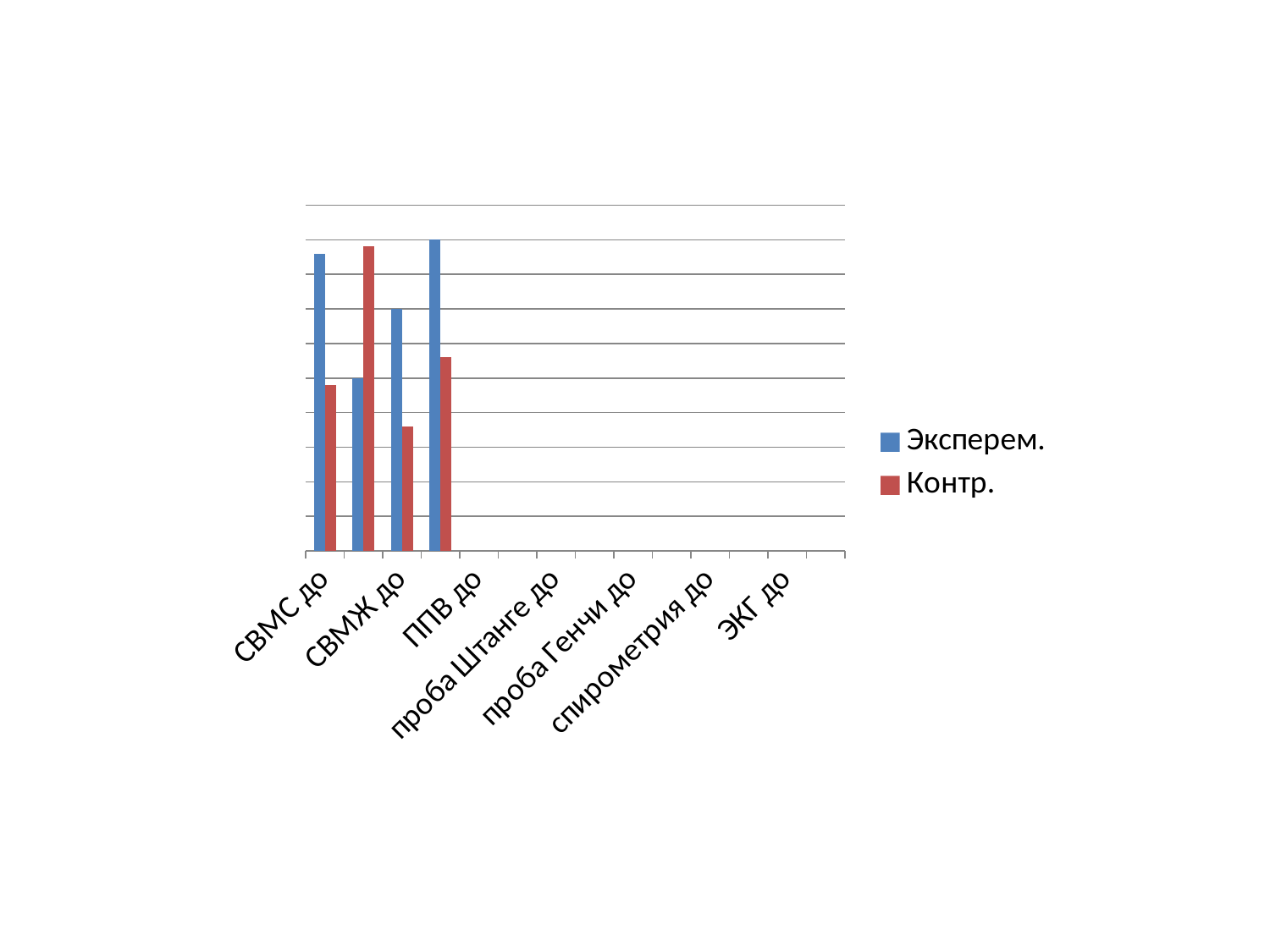
How many series does the legend list? 2 In the fourth group of bars from the left, which series has the taller bar, Эксперем. or Контр.? Эксперем. For the category СВМС до, which series has the taller bar, Эксперем. or Контр.? Эксперем. Which colour represents the Контр. series? red In the second group of bars from the left, which series has the taller bar, Эксперем. or Контр.? Контр. How many groups of bars are plotted on the chart? 4 What kind of chart is shown on the slide? bar chart How many category labels are shown along the x axis? 7 What are the two series named in the legend? Эксперем. and Контр.